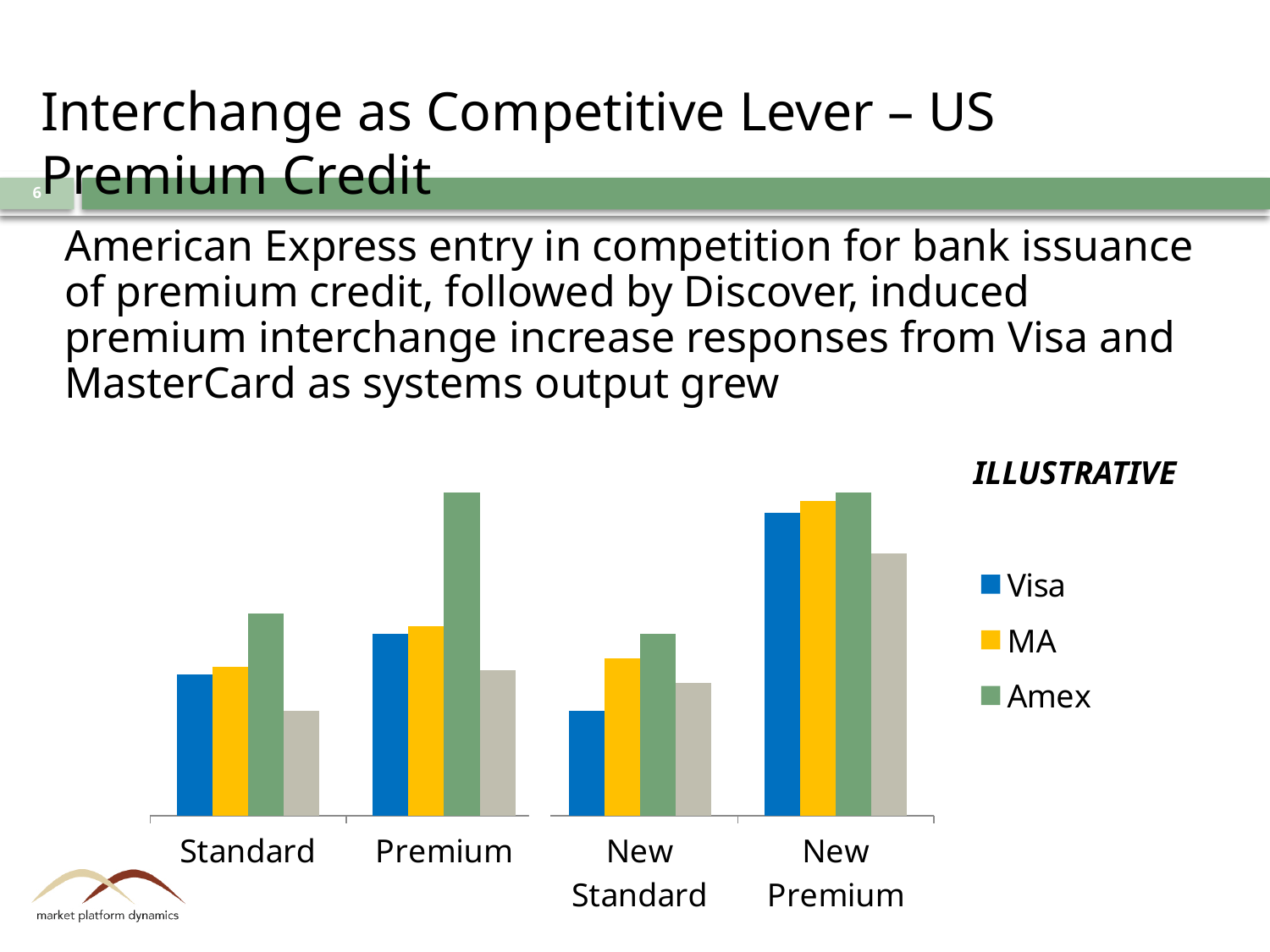
What kind of chart is shown on the slide? Bar chart Which series has the lowest bar in the New Standard category? Visa Is the Amex bar higher in Standard or in New Standard? Standard In which category is the Visa bar highest? New Premium How many series does the chart's legend list? 3 What word is printed in italics above the chart's legend? ILLUSTRATIVE How many categories are shown along the x axis of the chart? 4 Which series has the highest bar in the Premium category? Amex In which category is the Visa bar lowest? New Standard Is the Visa bar higher in Standard or in Premium? Premium Is the MA bar higher in New Premium or in New Standard? New Premium Which series is shown in green in the chart? Amex